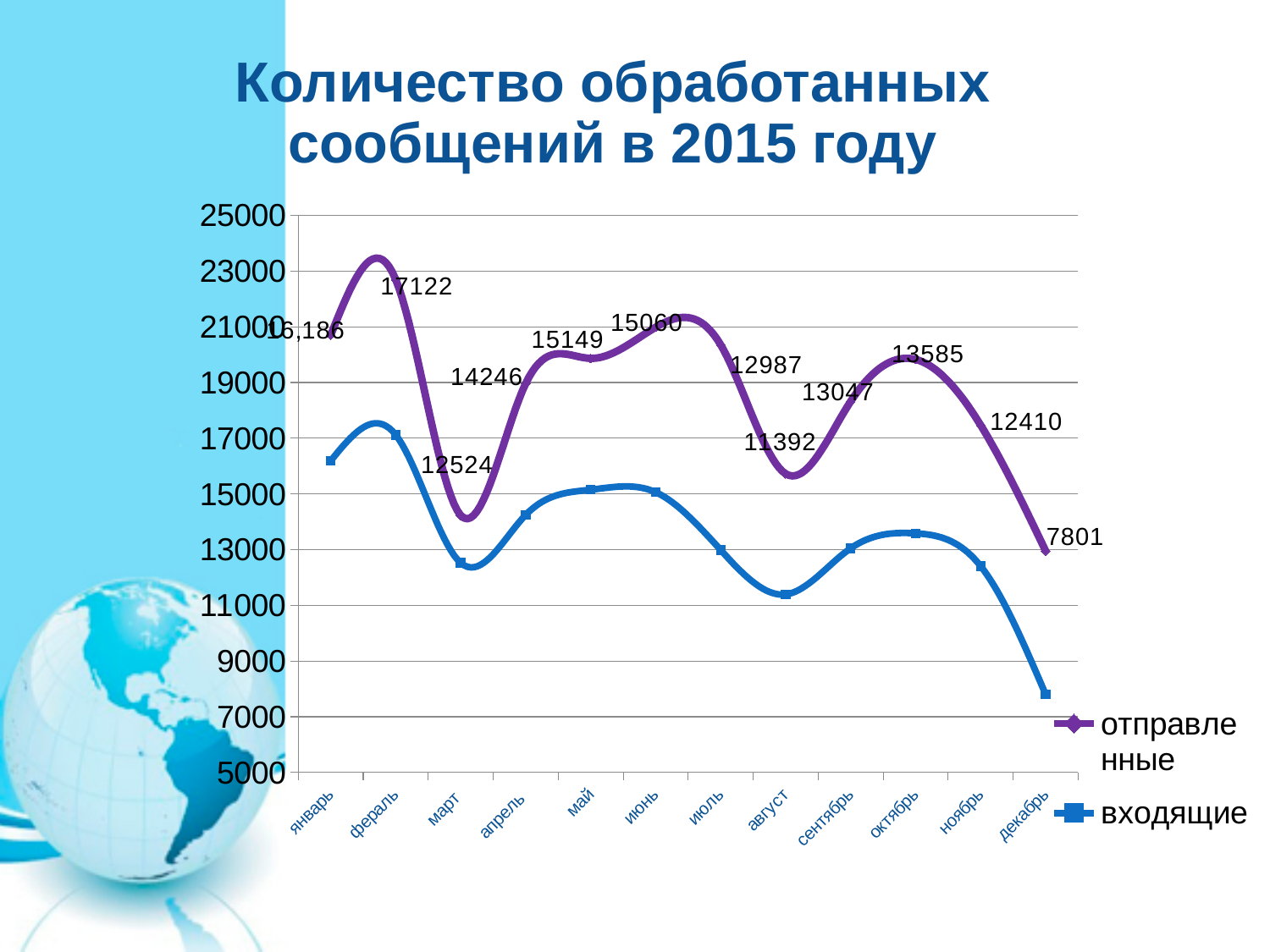
What kind of chart is shown on the slide? line chart What is the difference between входящие in февраль and in декабрь? 9321 In which month is входящие lowest? декабрь Is the value of отправленные for март greater or less than 15000? less What is the value of входящие for август? 11392 Do the values of входящие rise or fall from октябрь to декабрь? fall How many series does the legend list? 2 What is the value of входящие for февраль? 17122 How many months are plotted along the x axis? 12 What is the value of входящие for декабрь? 7801 In which month is входящие highest? февраль